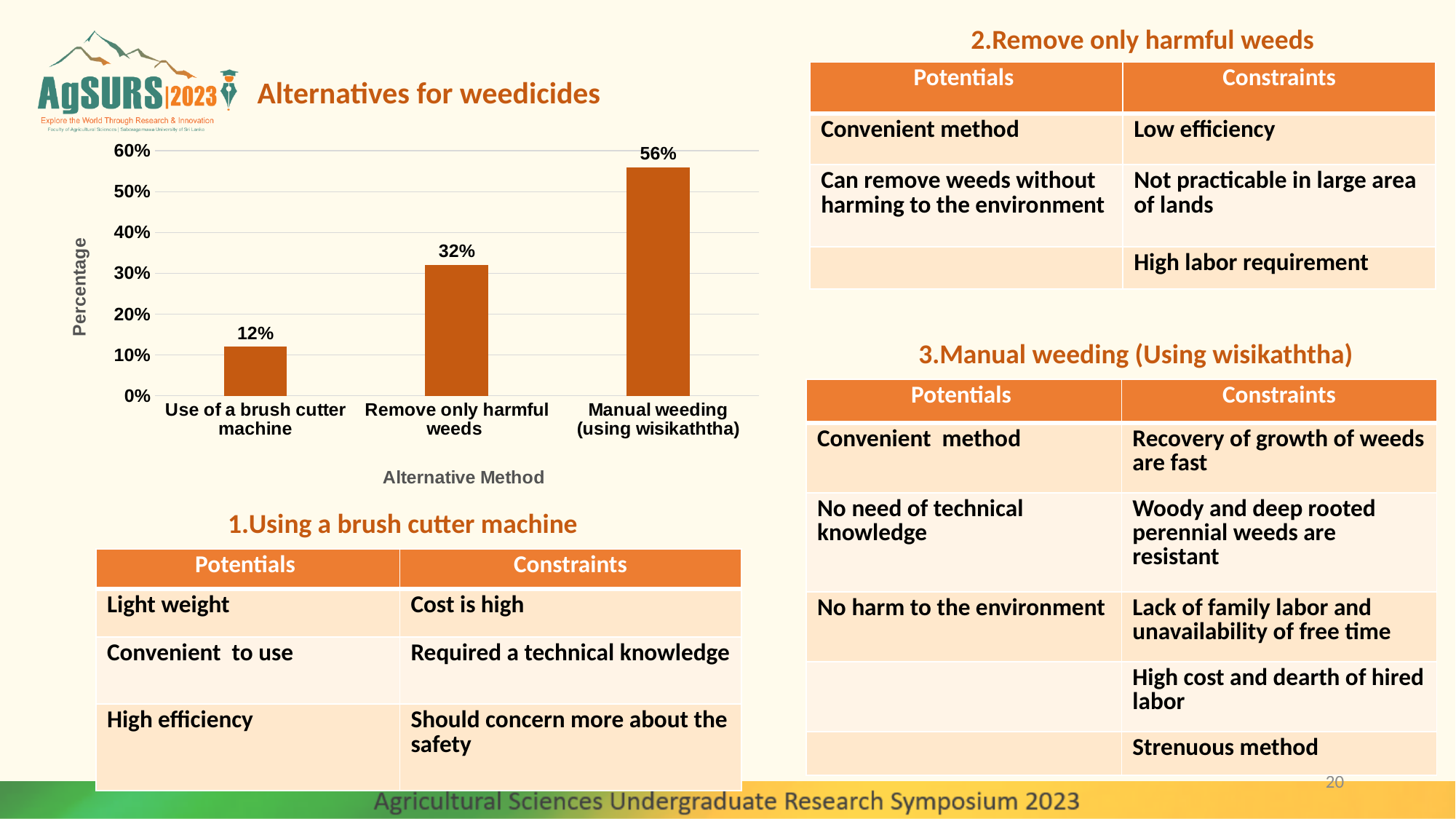
Which alternative method has the highest percentage? Manual weeding (using wisikaththa) What type of chart is used to show the alternatives for weedicides? Bar chart What is the label of the x axis of the chart? Alternative Method Which has a larger percentage: 'Remove only harmful weeds' or 'Use of a brush cutter machine'? Remove only harmful weeds What percentage is shown for 'Use of a brush cutter machine'? 12% What is the difference in percentage between 'Remove only harmful weeds' and 'Use of a brush cutter machine'? 20% Is the value for 'Manual weeding (using wisikaththa)' greater or less than 50%? greater What percentage is shown for 'Manual weeding (using wisikaththa)'? 56% What is the difference in percentage between 'Manual weeding (using wisikaththa)' and 'Remove only harmful weeds'? 24% How many alternative methods are shown on the chart? 3 What percentage is shown for 'Remove only harmful weeds'? 32% Which alternative method has the lowest percentage? Use of a brush cutter machine